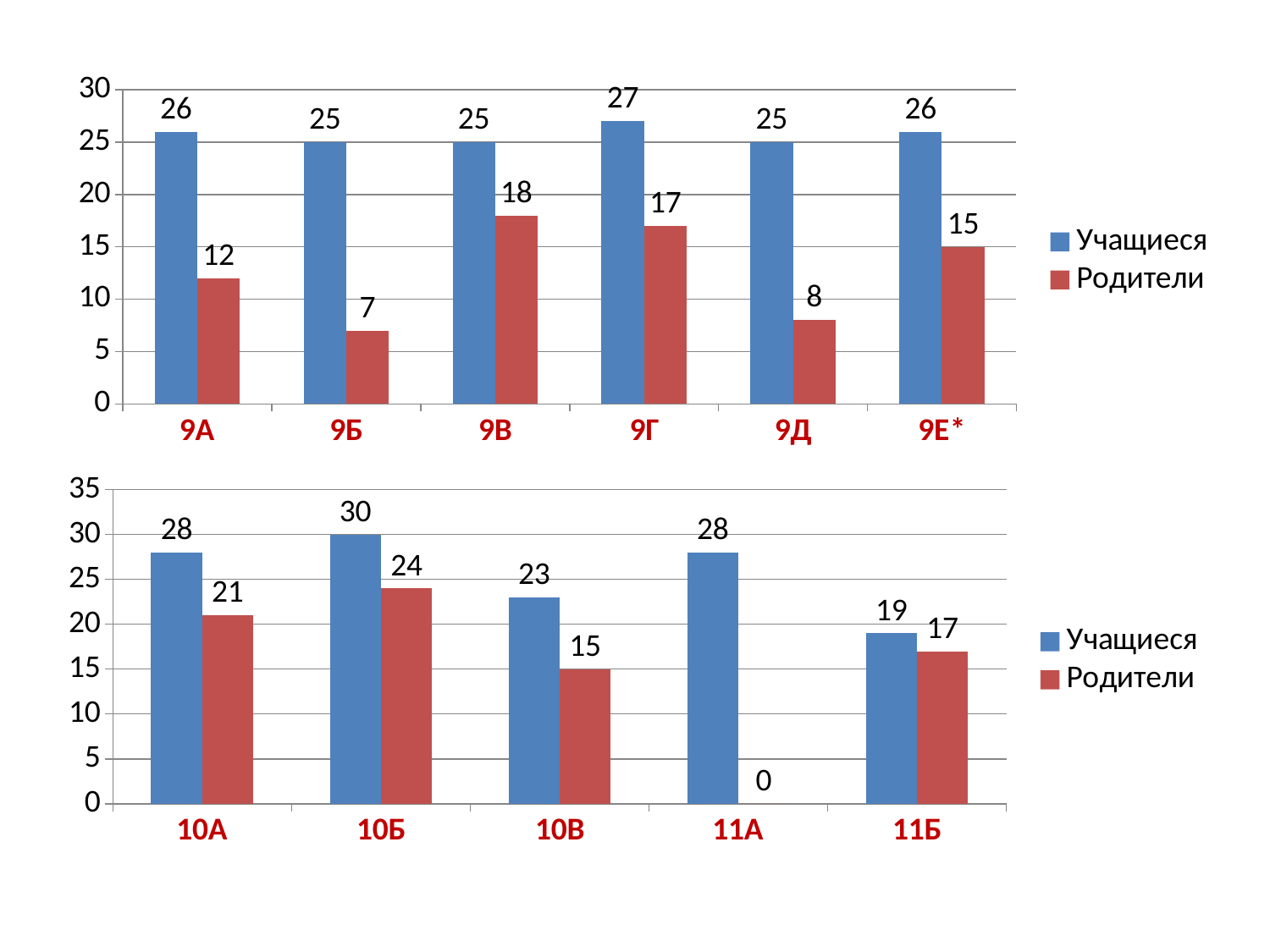
In the bottom chart, which category has the lowest Учащиеся value? 11Б What type of chart is the bottom chart? Bar chart In the top chart, which category has the highest Родители value? 9В In the top chart, how many categories are shown on the x axis? 6 In the bottom chart, what is the difference between Учащиеся and Родители in 10В? 8 In the top chart, what is the value for Учащиеся in 9Г? 27 In the top chart, which category has the lowest Родители value? 9Б In the bottom chart, what is the value for Родители in 10Б? 24 In the top chart, what is the value for Родители in 9Б? 7 In the bottom chart, how many series does the legend list? 2 In the bottom chart, which category has the highest Учащиеся value? 10Б In the top chart, what is the difference between Учащиеся and Родители in 9Д? 17